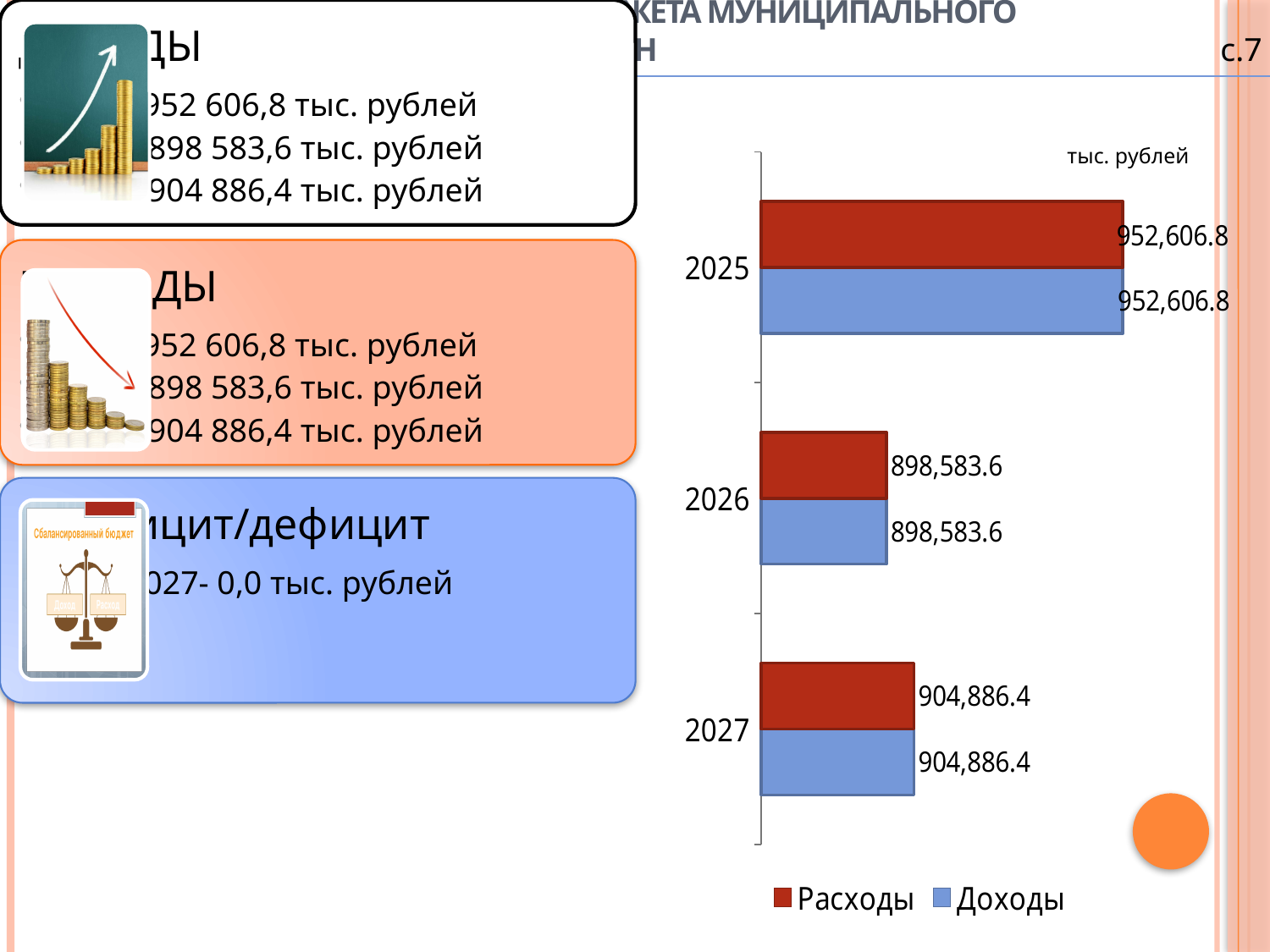
Which is larger: Доходы for 2025 or Доходы for 2027? 2025 What is the difference between the Расходы value for 2025 and the Расходы value for 2026? 54,023.2 What unit label is shown above the chart? тыс. рублей How many series does the chart legend list? 2 Which year has the highest value for Доходы? 2025 What is the value of Расходы for 2027? 904,886.4 What is the value of Расходы for 2025? 952,606.8 What type of chart is shown on the slide? Bar chart How many years (categories) are shown on the chart? 3 Which year has the lowest value for Расходы? 2026 What is the difference between the Доходы value for 2027 and the Доходы value for 2026? 6,302.8 What is the value of Доходы for 2026? 898,583.6